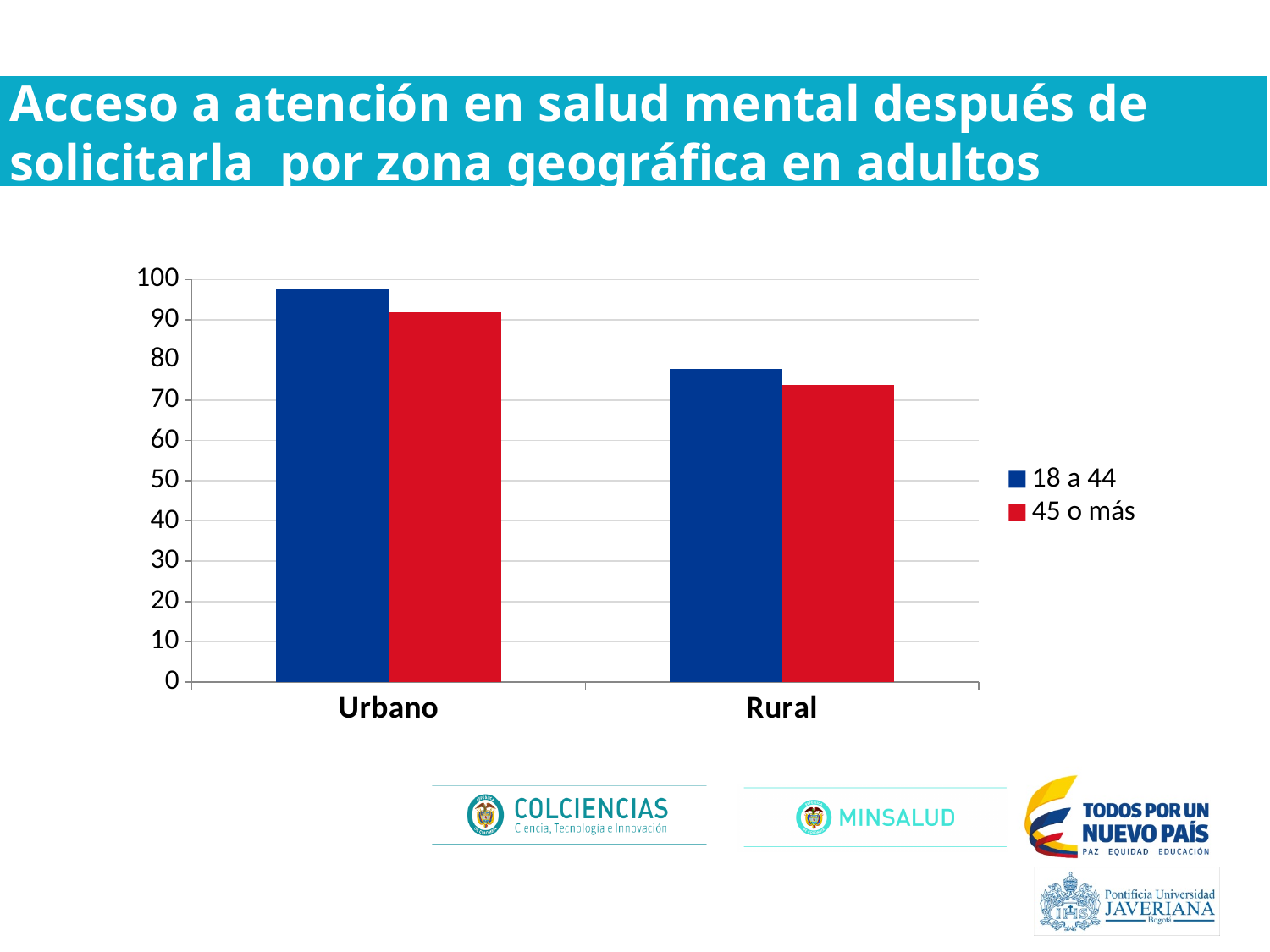
In Rural, which series has the larger value, 18 a 44 or 45 o más? 18 a 44 How many series does the legend list? 2 Which is larger: the 45 o más value in Urbano or the 18 a 44 value in Rural? 45 o más in Urbano How many categories are shown on the x axis? 2 Is the value for 18 a 44 in Urbano greater or less than 90? greater Is the value for 45 o más in Rural greater or less than 80? less Is the value for 45 o más in Urbano greater or less than 100? less Which category has the lowest bar for the 45 o más series? Rural What kind of chart is shown on the slide? bar chart Which category has the highest bar for the 18 a 44 series? Urbano Which series is shown in red in the legend? 45 o más